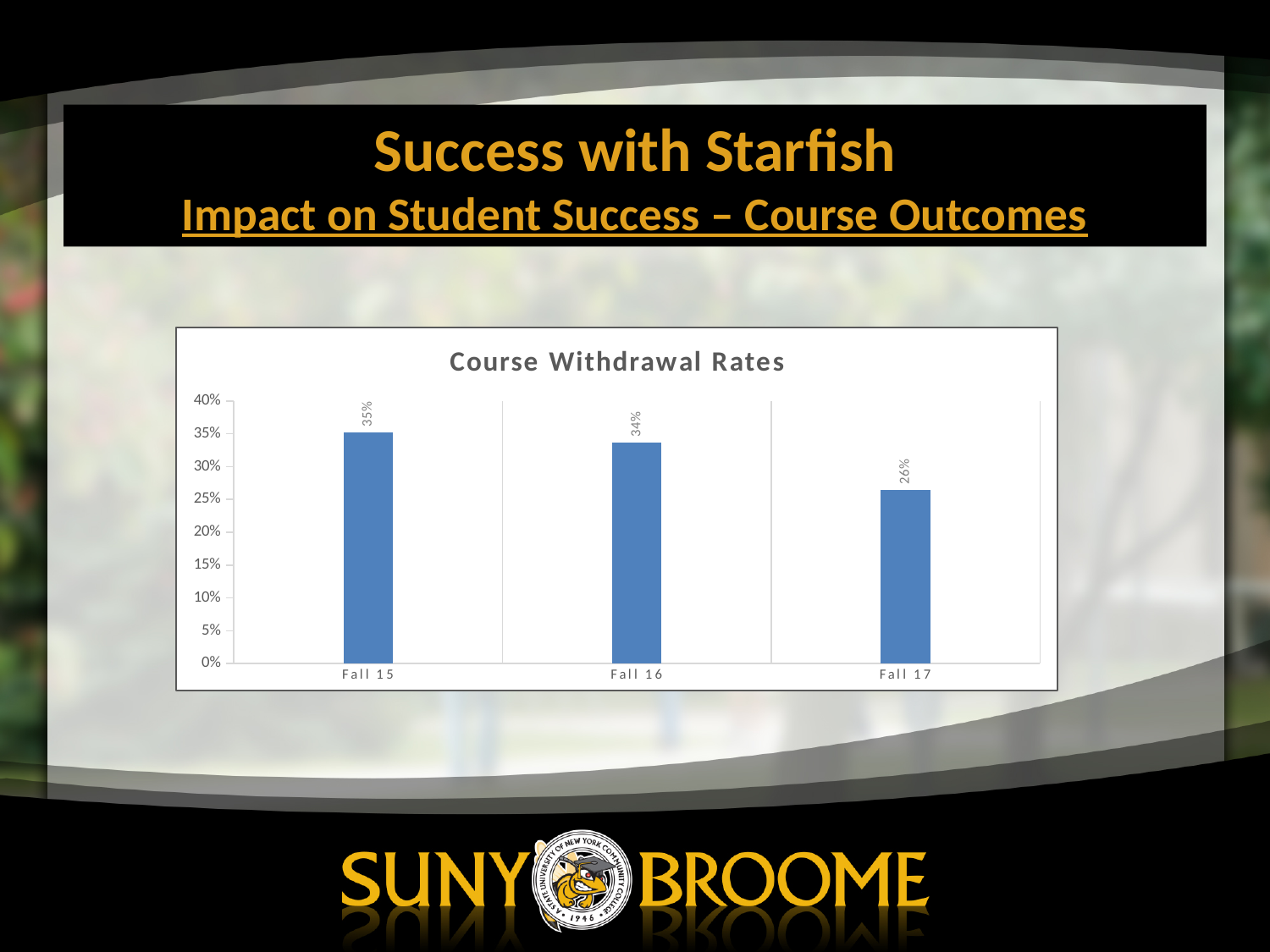
Which term has the highest course withdrawal rate? Fall 15 What is the difference in course withdrawal rate between Fall 16 and Fall 17? 8% Is the course withdrawal rate for Fall 17 greater or less than 30%? less What is the difference in course withdrawal rate between Fall 15 and Fall 17? 9% Which has a higher course withdrawal rate, Fall 16 or Fall 17? Fall 16 Which term has the lowest course withdrawal rate? Fall 17 What kind of chart is shown on the slide? Bar chart What is the course withdrawal rate for Fall 16? 34% How many terms are shown in the chart? 3 What is the course withdrawal rate for Fall 15? 35% What is the course withdrawal rate for Fall 17? 26% Do course withdrawal rates rise or fall from Fall 15 to Fall 17? Fall